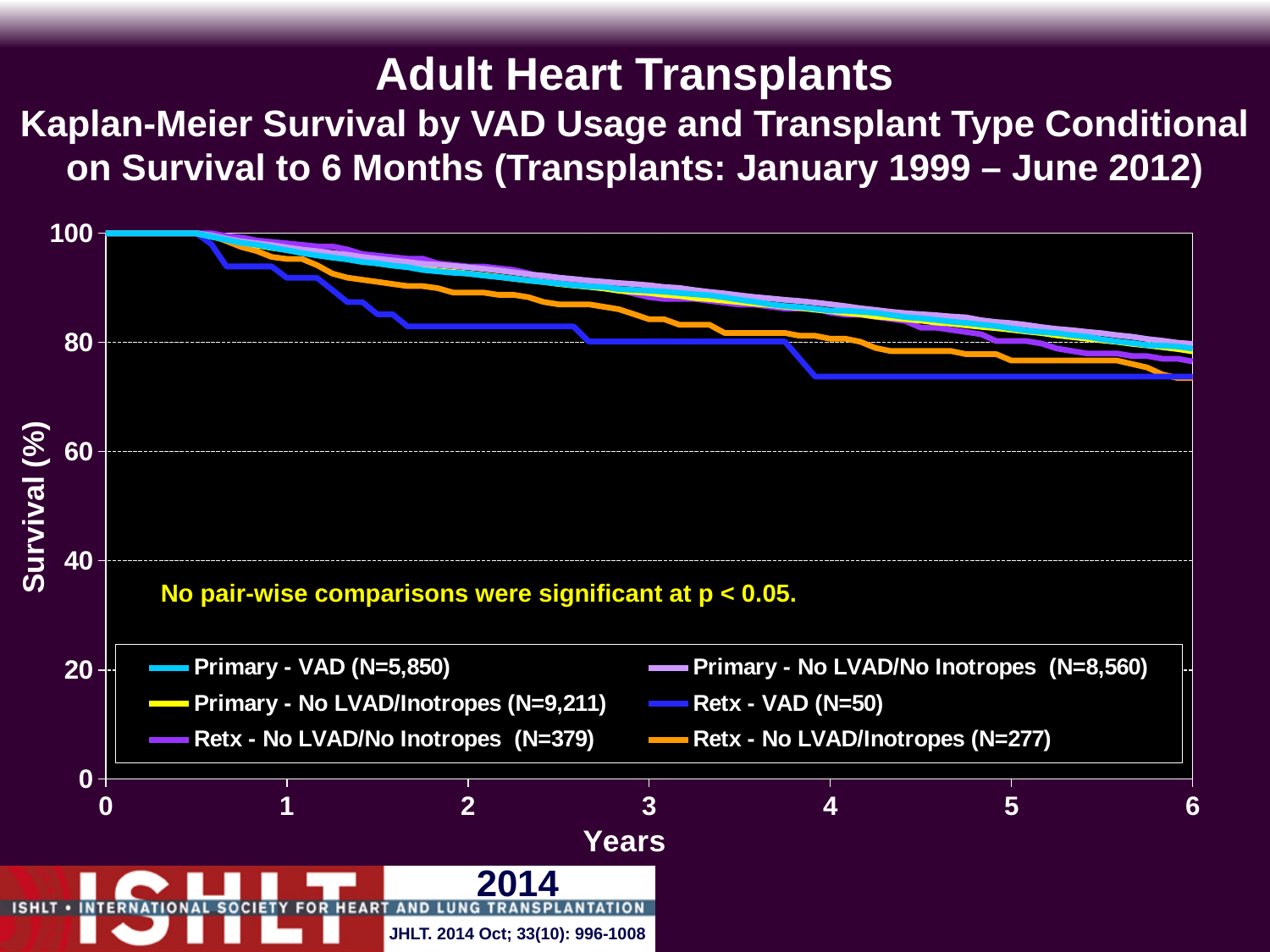
How many series does the legend list? 6 Is the survival value for Primary - VAD at year 6 greater or less than 60? greater Is the survival value for Primary - No LVAD/No Inotropes at year 3 greater or less than 80? greater Which series has the lowest survival at year 5? Retx - VAD What kind of chart is shown on the slide? line chart According to the legend, what is the N for the Retx - VAD series? N=50 What is the label of the y axis? Survival (%) Is the survival value for Retx - No LVAD/Inotropes at year 6 greater or less than 80? less Do the survival curves rise or fall as years increase? fall At year 4, which series has higher survival: Primary - VAD or Retx - VAD? Primary - VAD